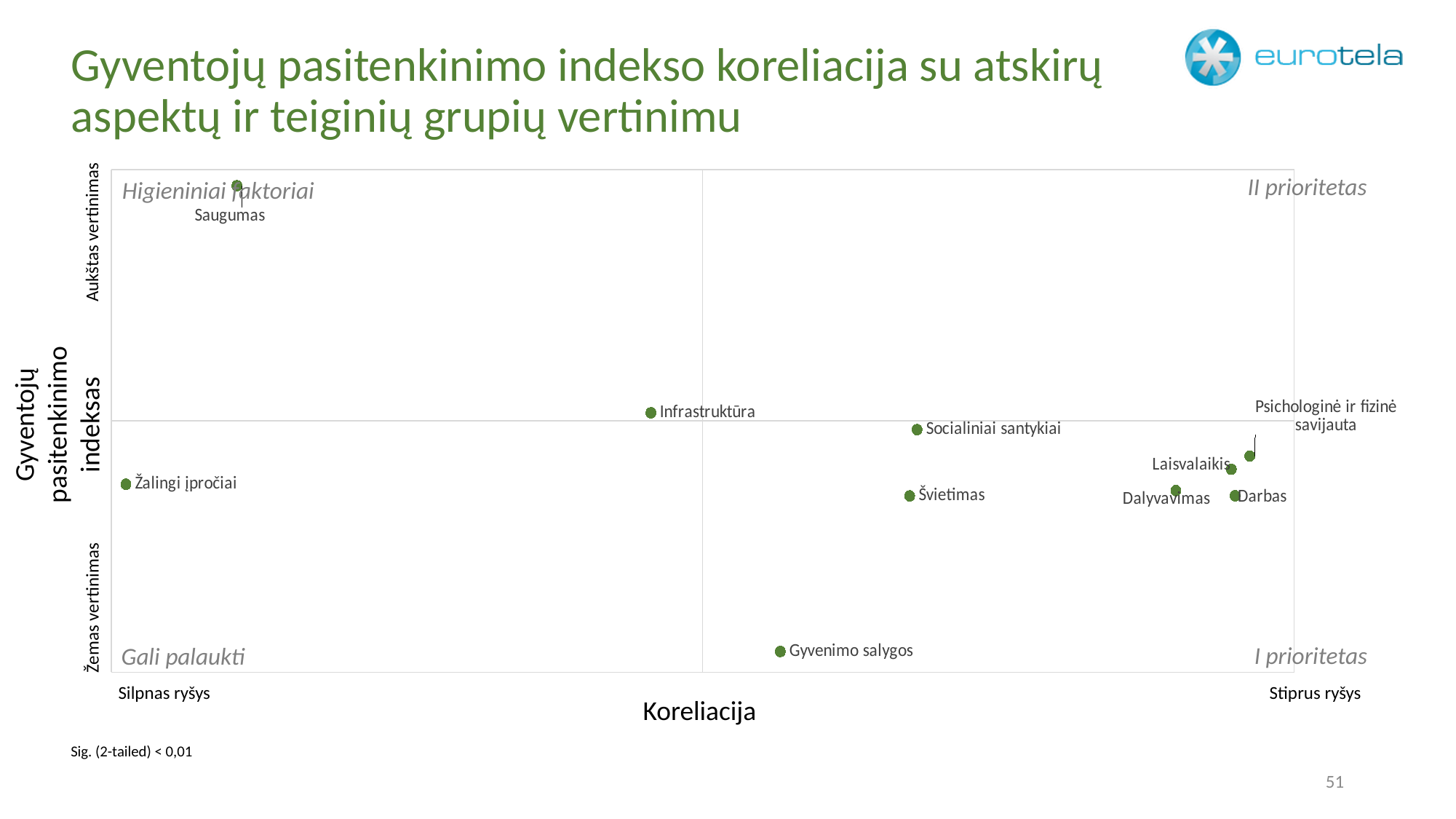
What kind of chart is shown on the slide? Scatter chart Which data point is positioned highest on the vertical axis (Gyventojų pasitenkinimo indeksas)? Saugumas Which data point is furthest to the right on the Koreliacija axis? Psichologinė ir fizinė savijauta What is the label of the horizontal axis of the chart? Koreliacija Which data point is furthest to the left on the Koreliacija axis? Žalingi įpročiai How many data points are plotted on the chart? 10 In which labelled quadrant does the point Gyvenimo salygos lie? I prioritetas In which labelled quadrant does the point Saugumas lie? Higieniniai faktoriai Which point is higher on the vertical axis, Saugumas or Infrastruktūra? Saugumas Which point lies further to the right on the Koreliacija axis, Darbas or Švietimas? Darbas What label appears in the top-right quadrant of the chart? II prioritetas Which data point is positioned lowest on the vertical axis? Gyvenimo salygos